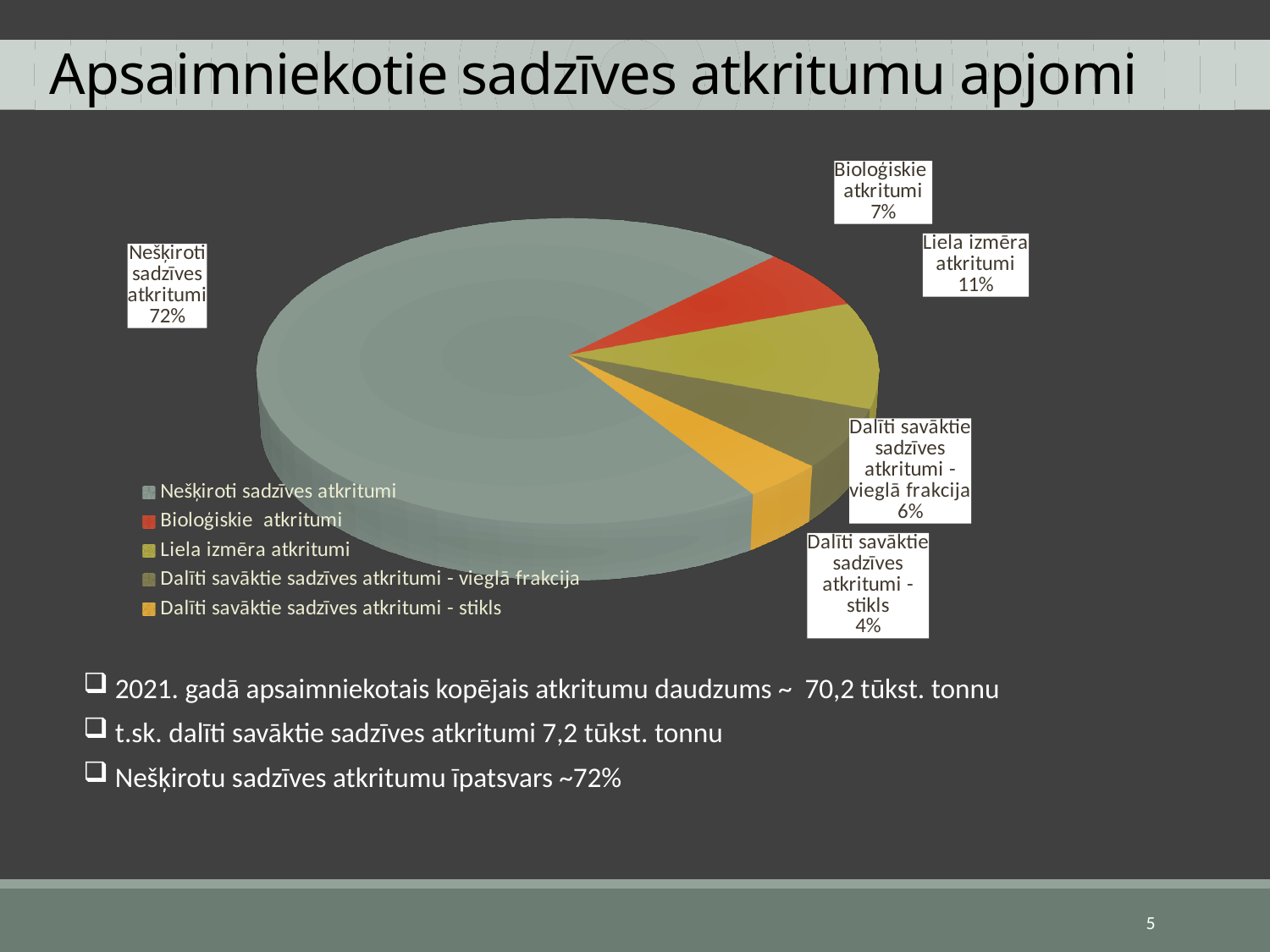
What kind of chart is shown on the slide? Pie chart Which is larger: Bioloģiskie atkritumi or Dalīti savāktie sadzīves atkritumi - vieglā frakcija? Bioloģiskie atkritumi What share of the pie does Dalīti savāktie sadzīves atkritumi - stikls have? 4% What share of the pie does Liela izmēra atkritumi have? 11% How many categories does the pie chart show? 5 What is the difference in percentage points between Liela izmēra atkritumi and Bioloģiskie atkritumi? 4% What is the title of the slide containing the pie chart? Apsaimniekotie sadzīves atkritumu apjomi What share of the pie does Dalīti savāktie sadzīves atkritumi - vieglā frakcija have? 6% Which category has the largest slice of the pie? Nešķiroti sadzīves atkritumi Which category has the smallest slice of the pie? Dalīti savāktie sadzīves atkritumi - stikls